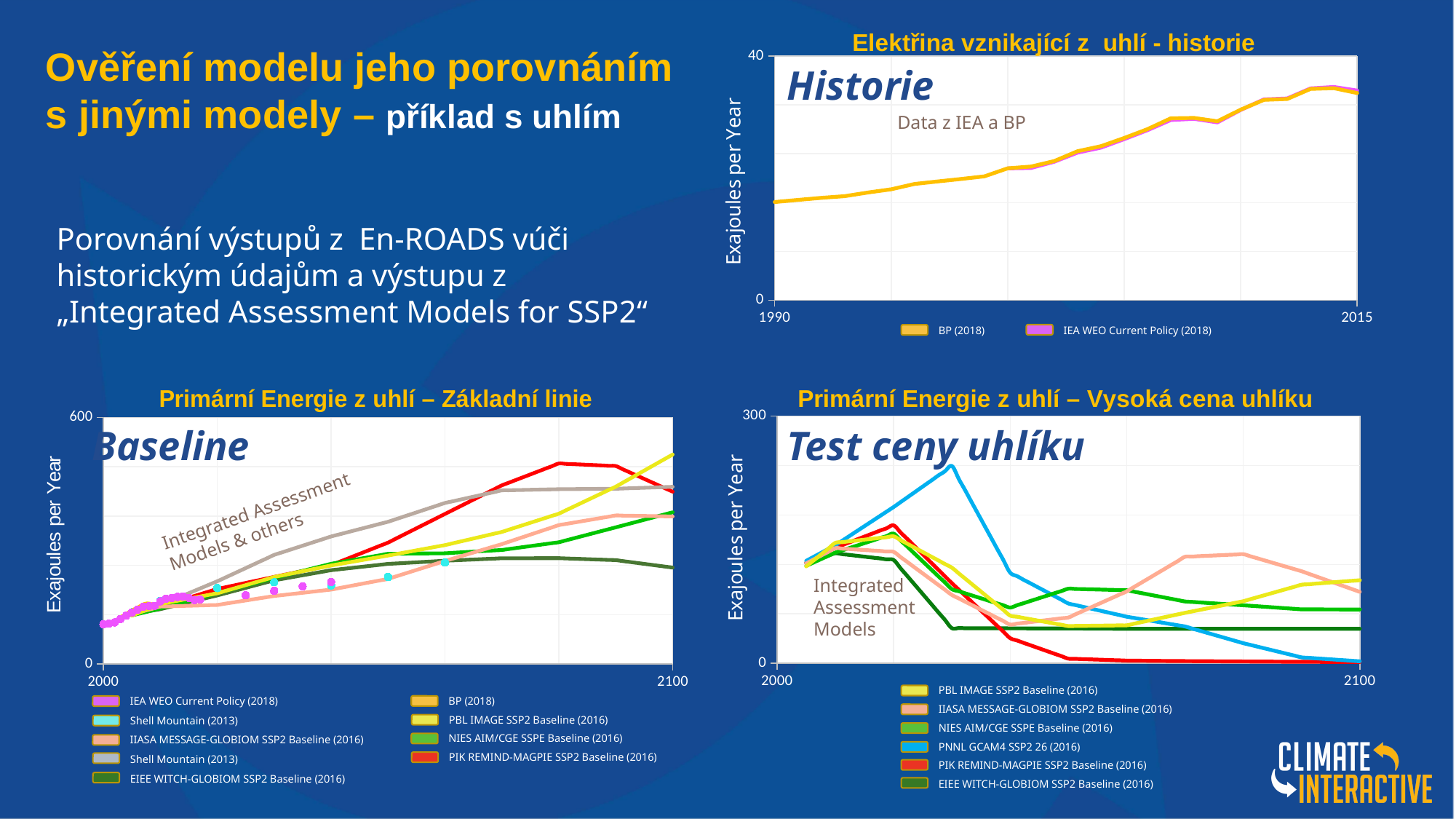
What is the y-axis label of the top-right chart 'Elektřina vznikající z uhlí - historie'? Exajoules per Year In the bottom-left chart 'Primární Energie z uhlí – Základní linie', which series has the highest value in 2100? PBL IMAGE SSP2 Baseline (2016) In the bottom-left chart 'Primární Energie z uhlí – Základní linie', which series has the lowest value in 2100? EIEE WITCH-GLOBIOM SSP2 Baseline (2016) What type of chart is the top-right chart titled 'Elektřina vznikající z uhlí - historie'? line chart How many series does the legend of the bottom-left chart 'Primární Energie z uhlí – Základní linie' list? 9 How many series does the legend of the bottom-right chart 'Primární Energie z uhlí – Vysoká cena uhlíku' list? 6 In the bottom-left chart 'Primární Energie z uhlí – Základní linie', is the value of PBL IMAGE SSP2 Baseline (2016) in 2100 greater or less than 600? less In the bottom-right chart 'Primární Energie z uhlí – Vysoká cena uhlíku', does the PIK REMIND-MAGPIE SSP2 Baseline (2016) series rise or fall between 2030 and 2100? fall In the top-right chart 'Elektřina vznikající z uhlí - historie', do the values rise or fall from 1990 to 2015? rise In the top-right chart 'Elektřina vznikající z uhlí - historie', is the value in 2015 greater or less than 40? less How many series does the legend of the top-right chart 'Elektřina vznikající z uhlí - historie' list? 2 In the bottom-right chart 'Primární Energie z uhlí – Vysoká cena uhlíku', which series reaches the highest peak value? PNNL GCAM4 SSP2 26 (2016)